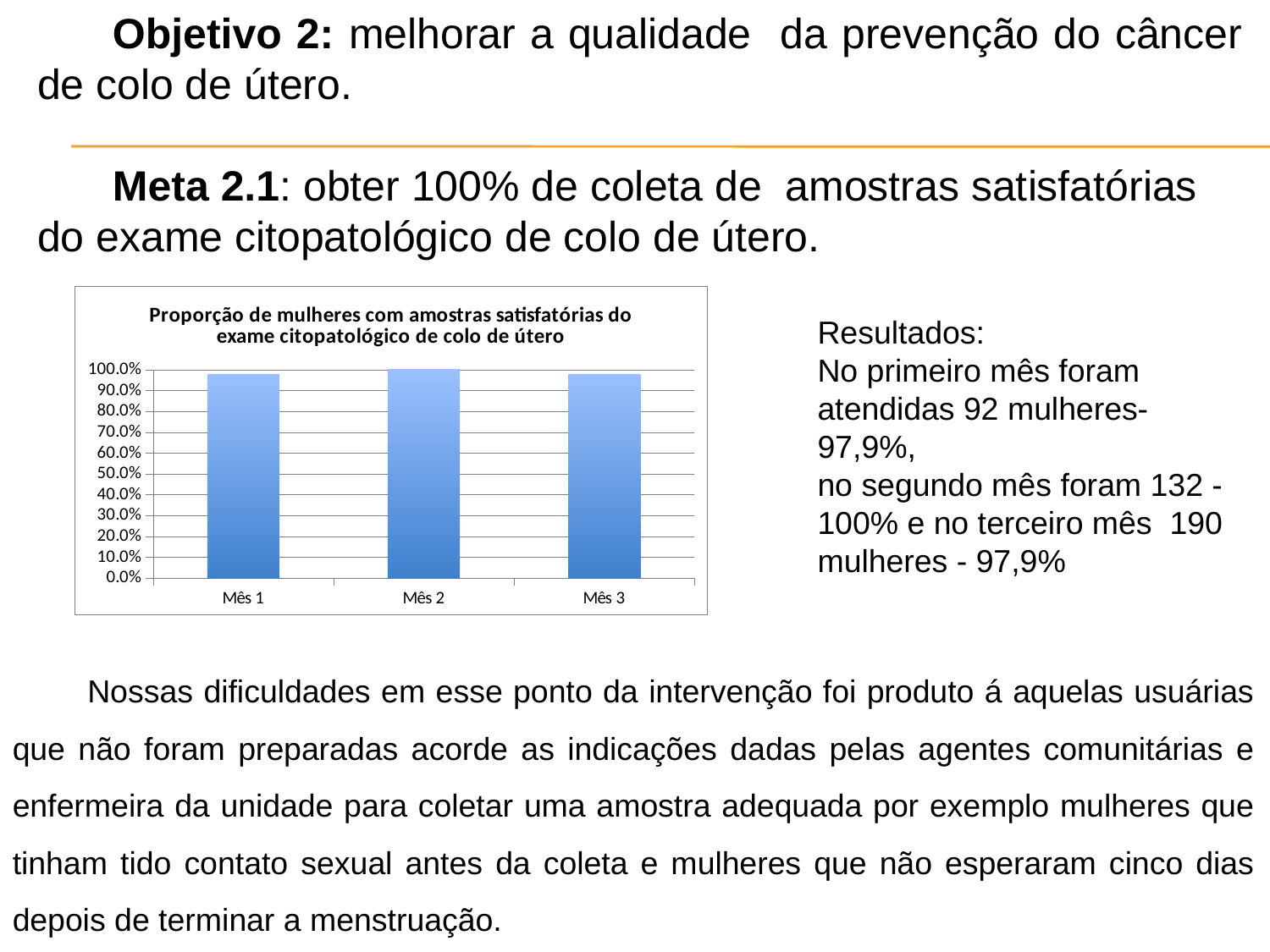
What is the highest value shown on the y axis of the chart? 100.0% What is the title of the chart? Proporção de mulheres com amostras satisfatórias do exame citopatológico de colo de útero Is the value for Mês 3 greater or less than 80.0%? greater Which is larger, the value for Mês 2 or the value for Mês 3? Mês 2 Is the value for Mês 1 greater or less than 90.0%? greater What type of chart is shown on the slide? bar chart What is the value for Mês 2 in the chart? 100.0% How many months (categories) are plotted in the chart? 3 Which month has the highest proportion of women with satisfactory samples? Mês 2 What is the label of the first category on the x axis? Mês 1 Which is larger, the value for Mês 2 or the value for Mês 1? Mês 2